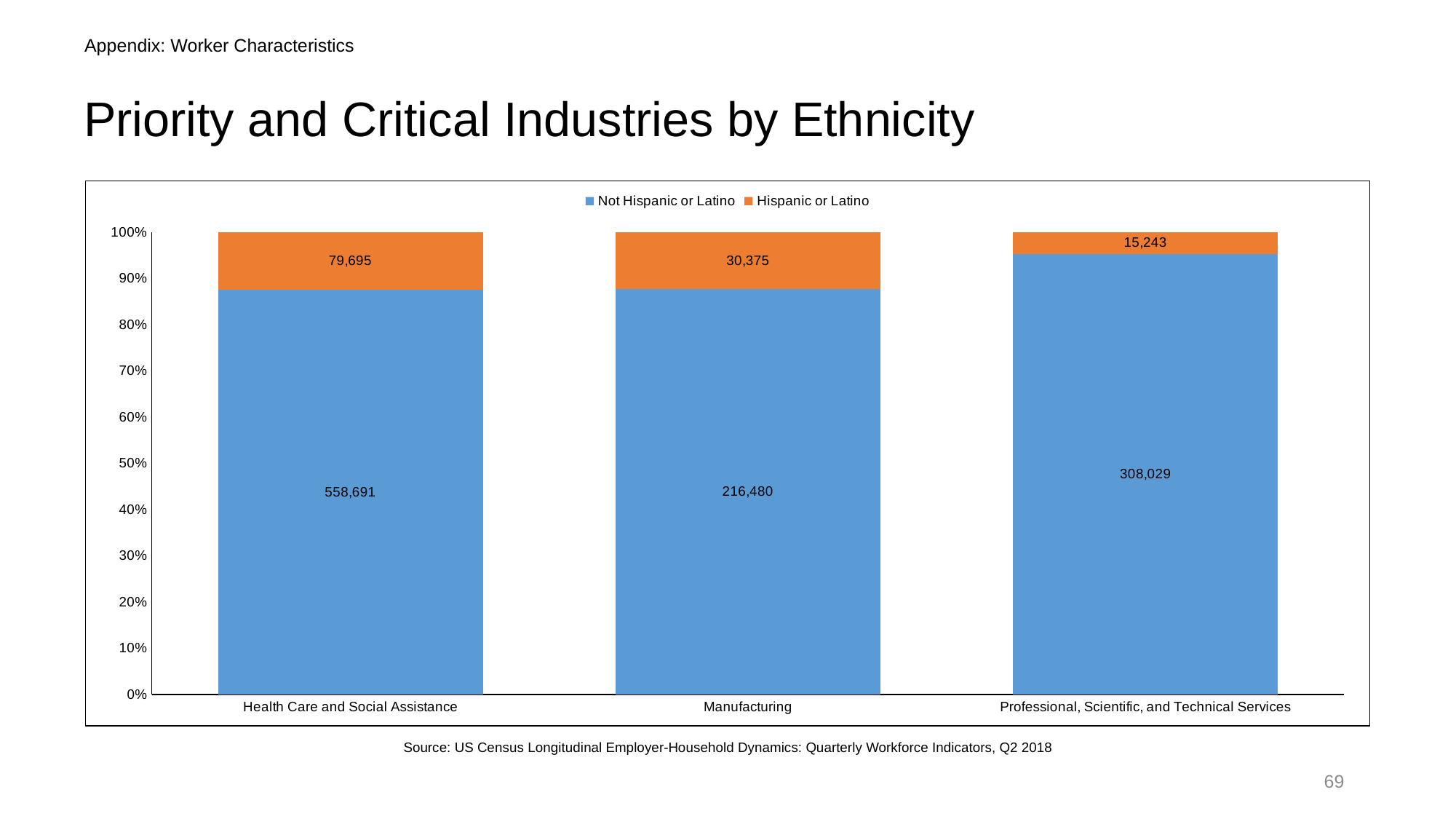
What is the value for Hispanic or Latino in Professional, Scientific, and Technical Services? 15,243 What is the value for Hispanic or Latino in Manufacturing? 30,375 Which is larger: the Not Hispanic or Latino value for Manufacturing or for Professional, Scientific, and Technical Services? Professional, Scientific, and Technical Services What is the difference between the Hispanic or Latino values for Health Care and Social Assistance and Manufacturing? 49,320 What is the value for Not Hispanic or Latino in Health Care and Social Assistance? 558,691 What is the difference between the Not Hispanic or Latino and Hispanic or Latino values in Health Care and Social Assistance? 478,996 How many industries are shown on the x axis? 3 Is the Hispanic or Latino share of the Professional, Scientific, and Technical Services bar greater or less than 10%? less Which industry has the lowest Hispanic or Latino value? Professional, Scientific, and Technical Services Which industry has the highest Not Hispanic or Latino value? Health Care and Social Assistance How many series does the legend list? 2 What is the total of the Manufacturing bar (Not Hispanic or Latino plus Hispanic or Latino)? 246,855